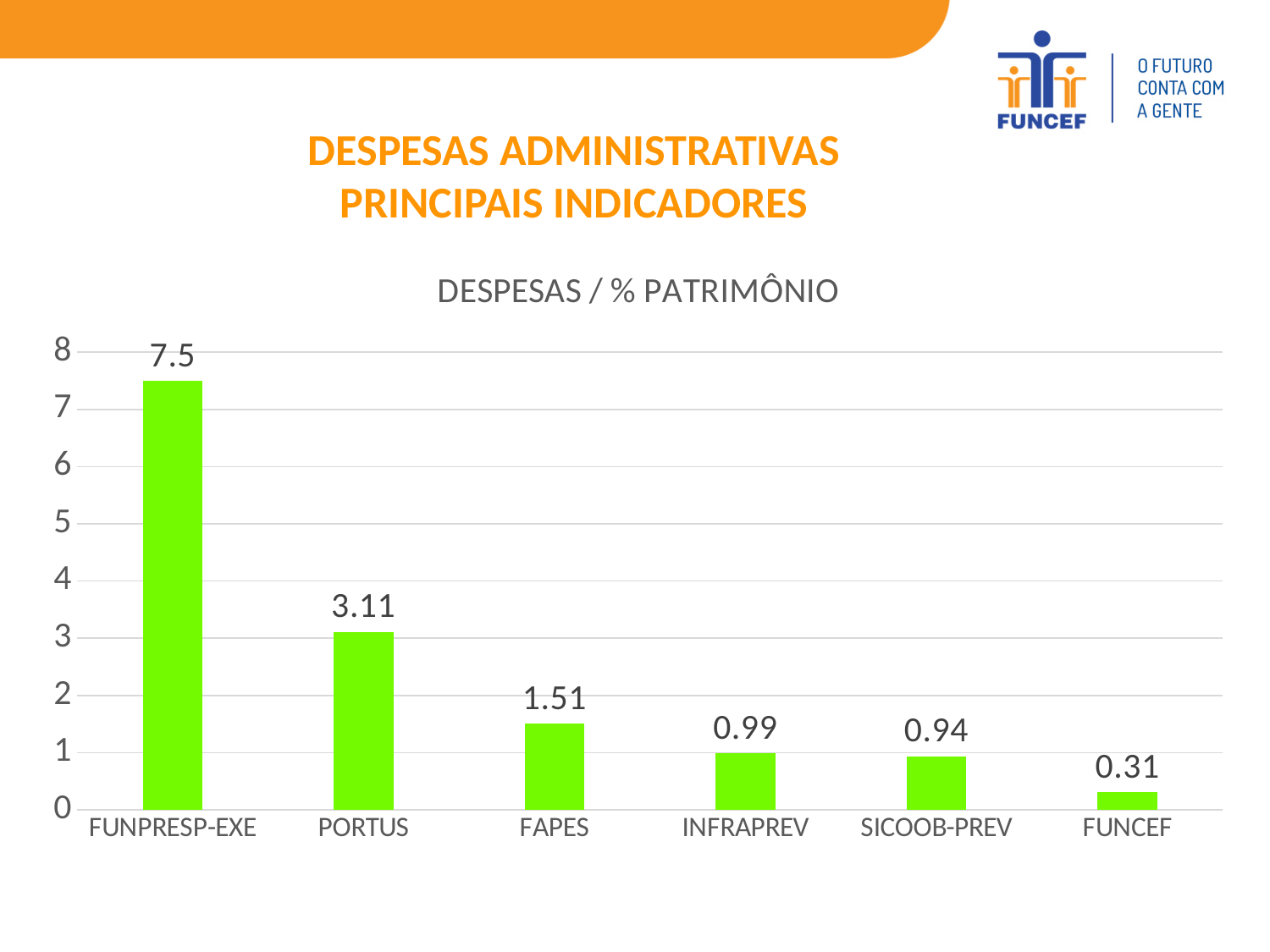
What kind of chart is shown on the slide? bar chart What is the title of the chart? DESPESAS / % PATRIMÔNIO How many categories are shown in the chart? 6 Which is larger, the value for FAPES or the value for INFRAPREV? FAPES Which category has the lowest value? FUNCEF What is the value for FUNPRESP-EXE? 7.5 What is the value for FUNCEF? 0.31 Which category has the highest value? FUNPRESP-EXE Is the value for PORTUS greater or less than 3? greater What is the value for PORTUS? 3.11 What is the value for FAPES? 1.51 What is the difference between the values for FUNPRESP-EXE and PORTUS? 4.39